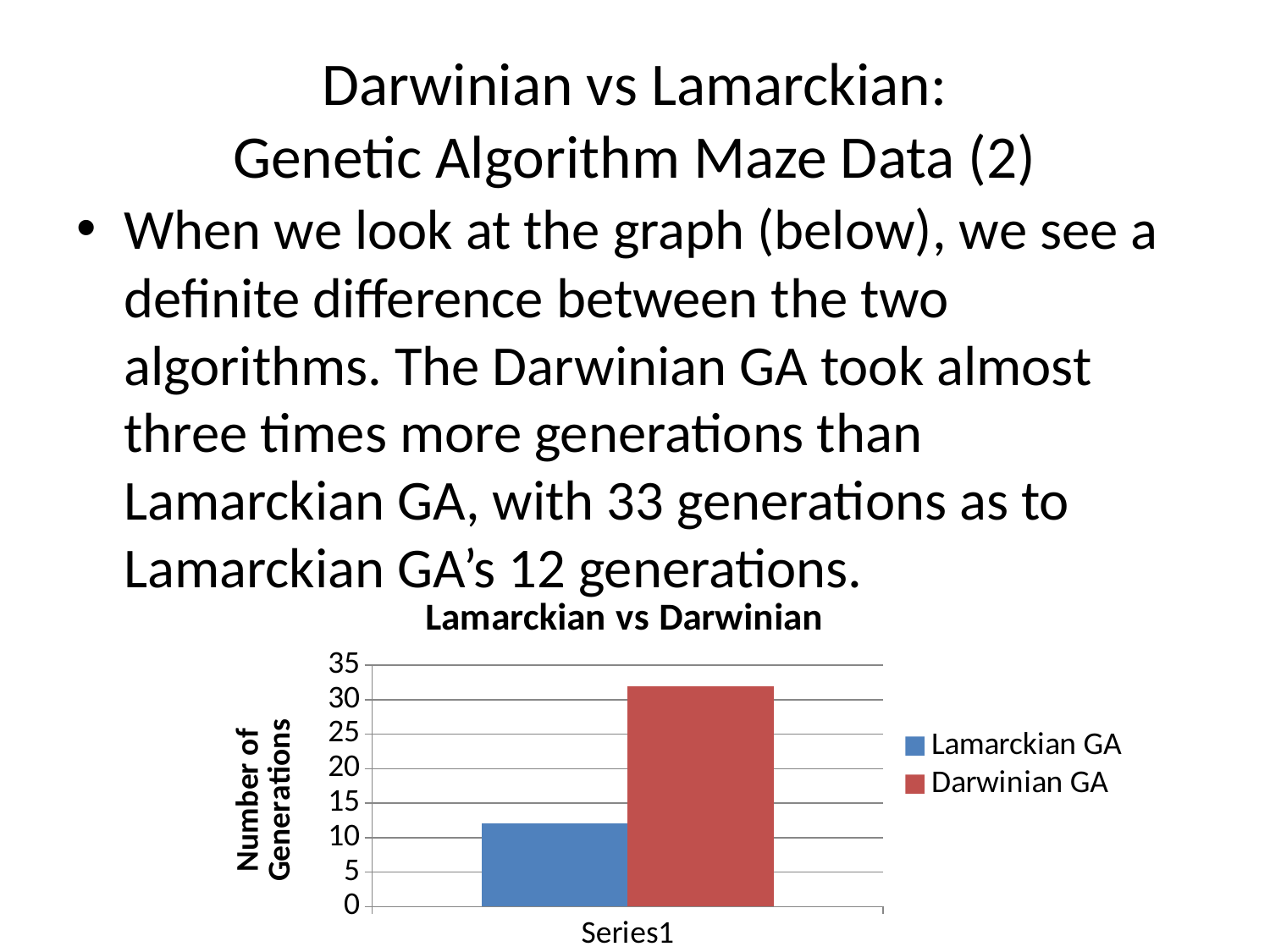
Is the bar for Lamarckian GA larger or smaller than the bar for Darwinian GA? smaller Is the value for Lamarckian GA greater or less than 15? less Is the value for Darwinian GA greater or less than 35? less What is the label of the vertical axis of the chart? Number of Generations How many categories are shown on the x axis of the chart? 1 What is the title of the chart? Lamarckian vs Darwinian Is the value for Lamarckian GA greater or less than 10? greater Which series has the taller bar in the chart? Darwinian GA Which series has the shorter bar in the chart? Lamarckian GA How many series does the chart legend list? 2 What kind of chart is shown on the slide? bar chart